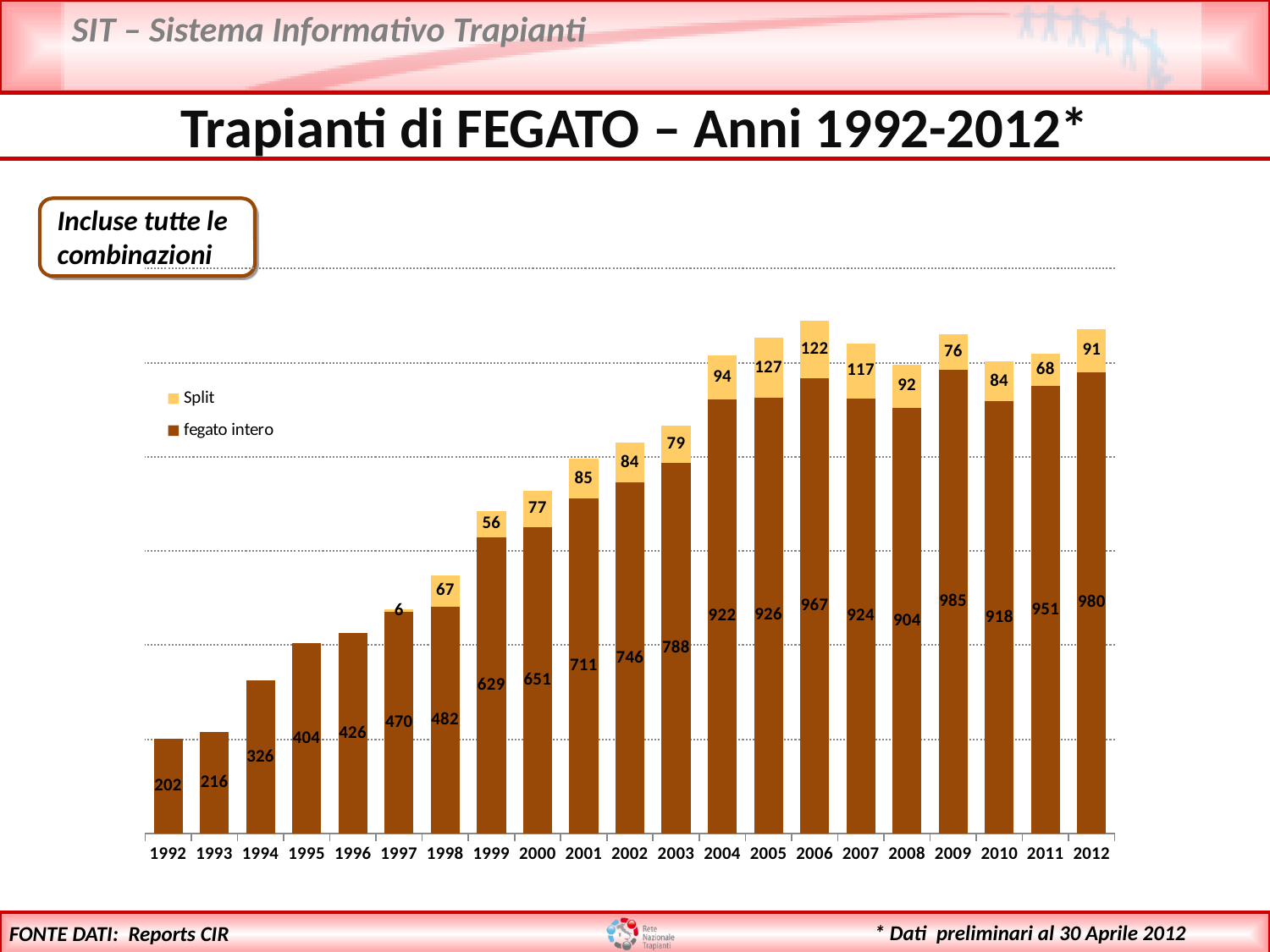
What is the total of the stacked bar for 2006? 1089 What is the value for fegato intero in 2009? 985 What is the Split value for 2005? 127 What kind of chart is shown on the slide? Stacked bar chart Which series is shown in yellow in the legend? Split Which is larger, the fegato intero value for 2006 or for 2007? 2006 How many series does the legend list? 2 How many years are shown on the x axis? 21 Which year has the highest Split value? 2005 Which year has the lowest fegato intero value? 1992 What is the difference between the fegato intero values for 2012 and 2011? 29 Which year has the highest fegato intero value? 2009